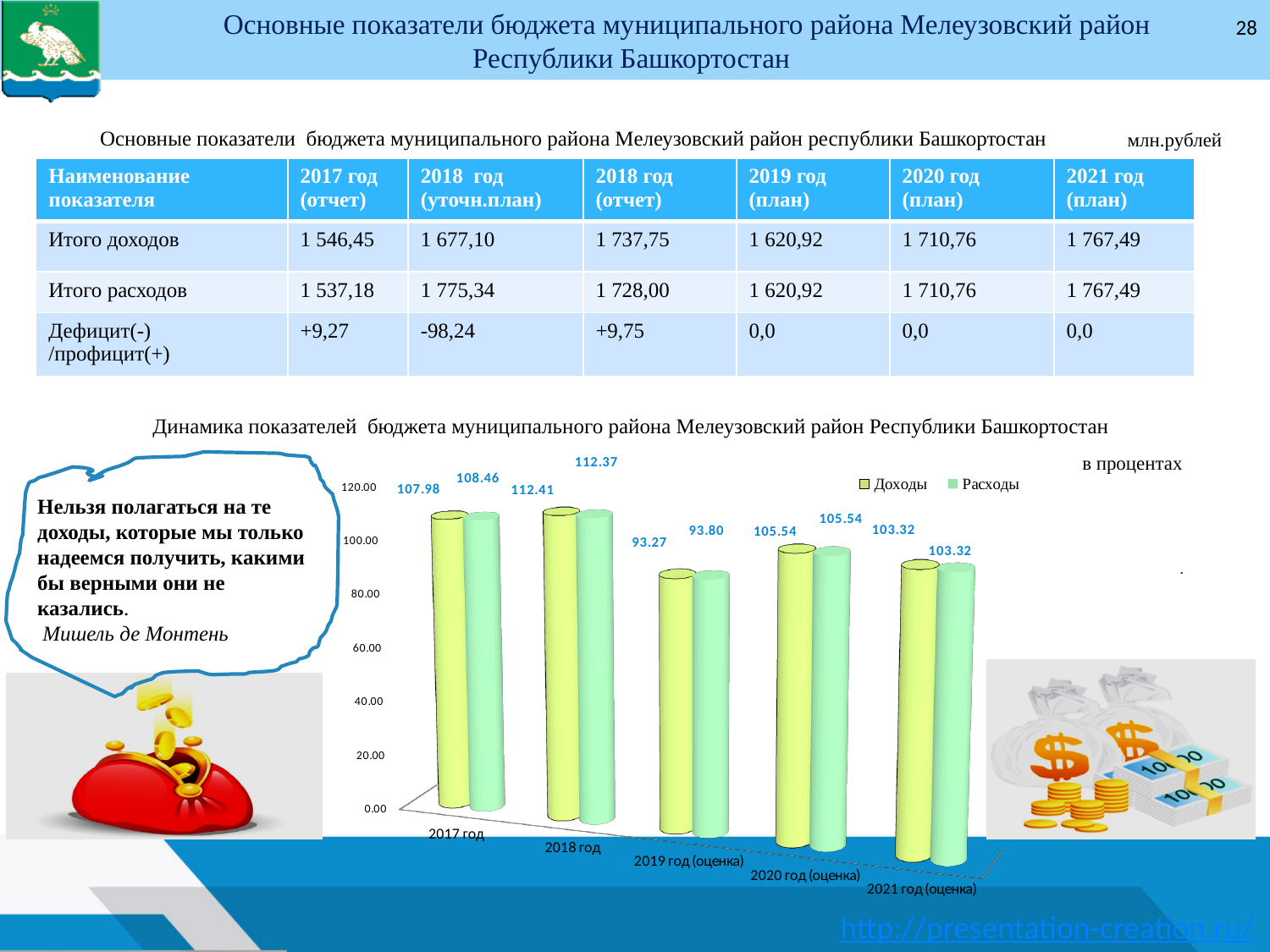
How many years are shown on the x axis of the chart? 5 What kind of chart is shown on the slide? bar chart What are the two series named in the chart legend? Доходы and Расходы Is the value of Доходы for 2019 год (оценка) greater or less than 100.00? less What is the value of Доходы for 2018 год? 112.41 How many series does the chart legend list? 2 What is the value of Расходы for 2019 год (оценка)? 93.80 Which is larger: Доходы for 2017 год or Доходы for 2020 год (оценка)? 2017 год Which year has the highest value for Доходы? 2018 год What is the value of Доходы for 2021 год (оценка)? 103.32 What is the difference between Доходы for 2018 год and Доходы for 2019 год (оценка)? 19.14 Which year has the lowest value for Расходы? 2019 год (оценка)